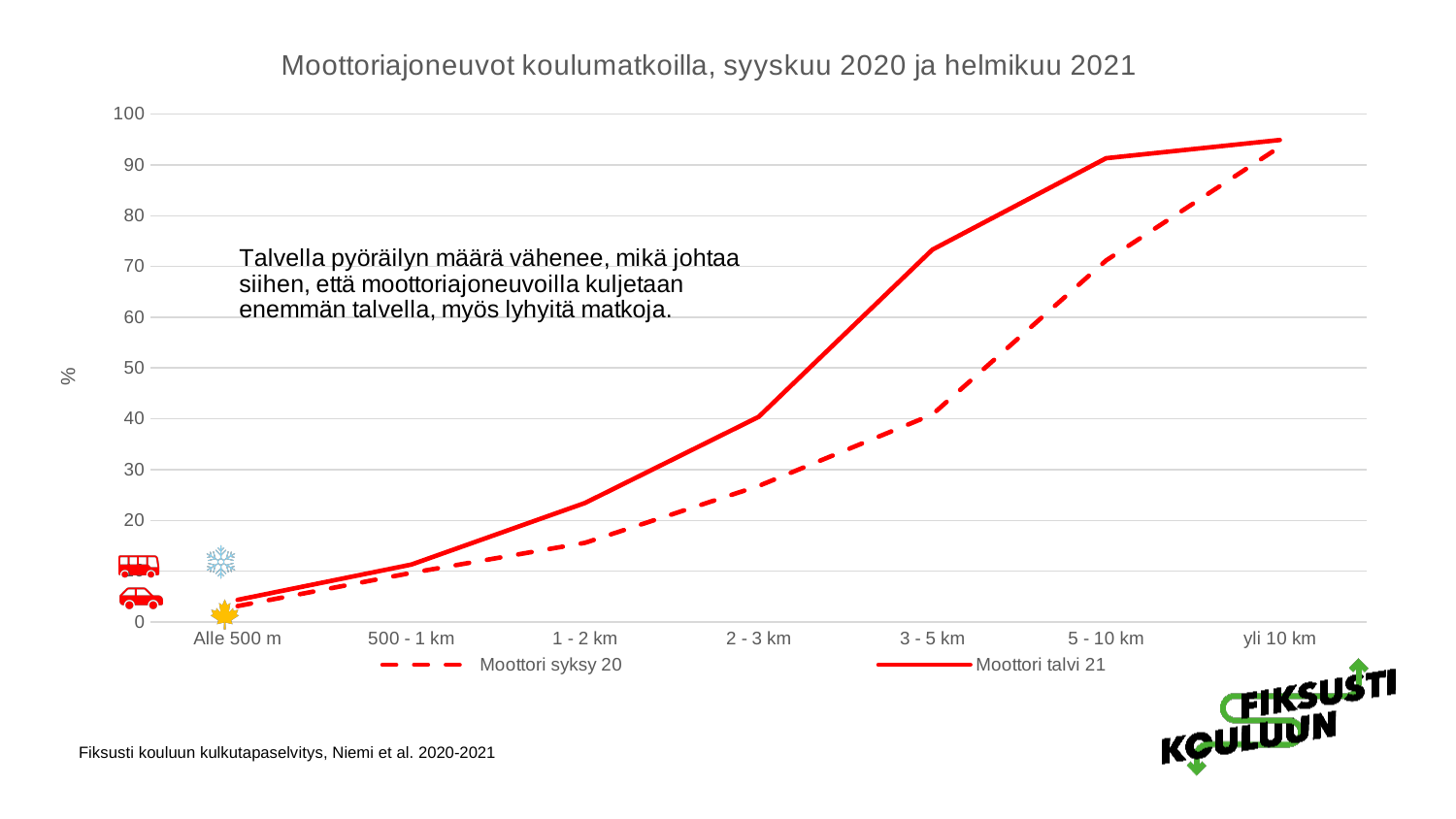
Do the values for Moottori talvi 21 rise or fall as the distance increases along the x axis? rise Is the value for Moottori syksy 20 at 3 - 5 km greater or less than 50? less Is the value for Moottori talvi 21 at 3 - 5 km greater or less than 60? greater For which distance category is the value for Moottori syksy 20 lowest? Alle 500 m What kind of chart is shown on the slide? line chart Which series is drawn with a dashed line? Moottori syksy 20 How many series does the legend list? 2 Is the value for Moottori syksy 20 at 1 - 2 km greater or less than 20? less What is the title of the chart? Moottoriajoneuvot koulumatkoilla, syyskuu 2020 ja helmikuu 2021 How many distance categories are shown on the x axis? 7 For which distance category is the value for Moottori talvi 21 highest? yli 10 km At 3 - 5 km, which series has the higher value, Moottori syksy 20 or Moottori talvi 21? Moottori talvi 21